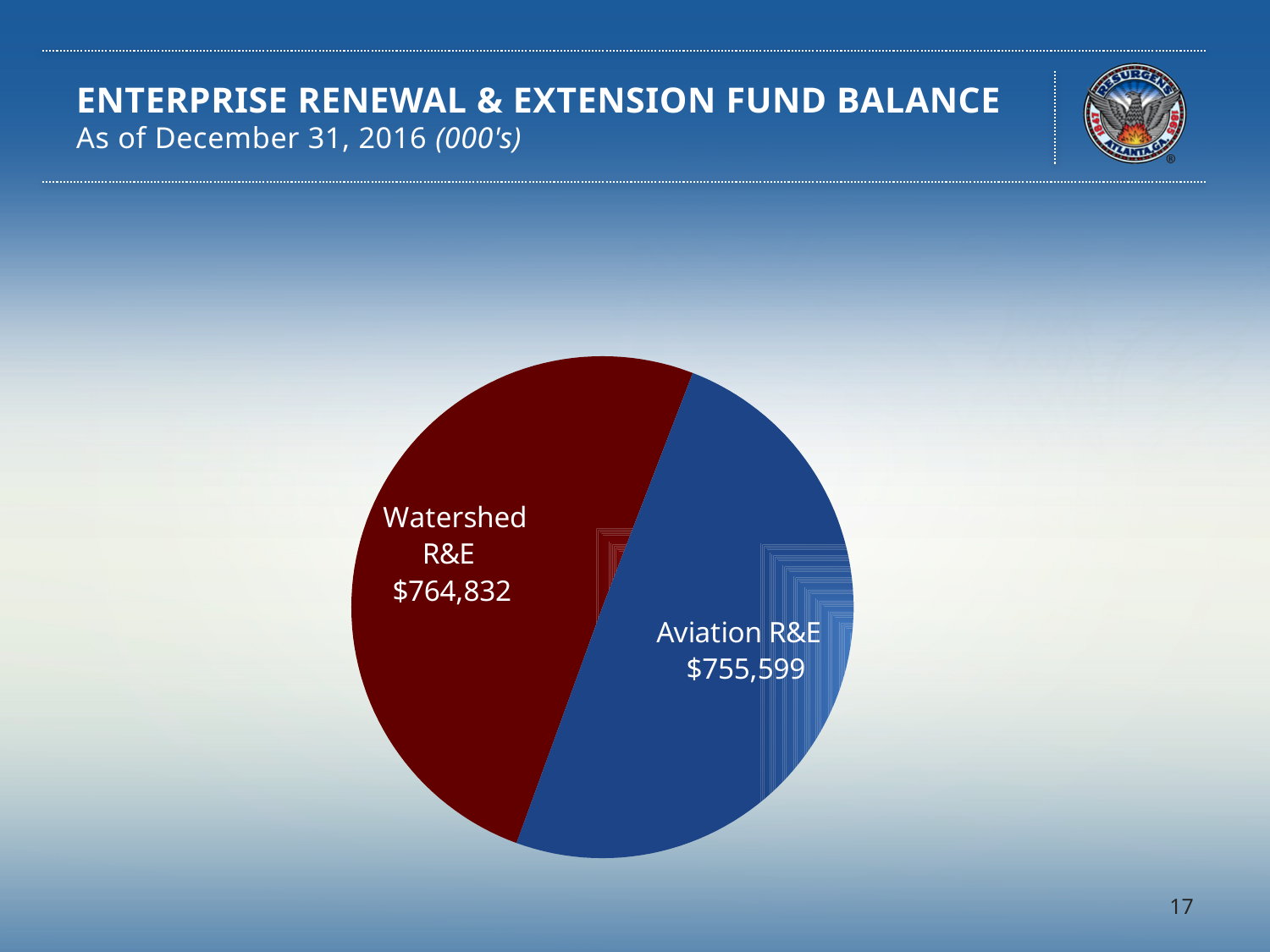
What colour is the Aviation R&E slice? Blue What is the value shown for Watershed R&E? $764,832 What is the value shown for Aviation R&E? $755,599 Which category has the smallest value in the pie chart? Aviation R&E What is the difference between the Watershed R&E and Aviation R&E values? $9,233 How many slices does the pie chart have? 2 What type of chart is shown on the slide? Pie chart Which slice has the larger value, Watershed R&E or Aviation R&E? Watershed R&E What is the title of the slide containing the pie chart? ENTERPRISE RENEWAL & EXTENSION FUND BALANCE What is the combined total of the two slices in the pie chart? $1,520,431